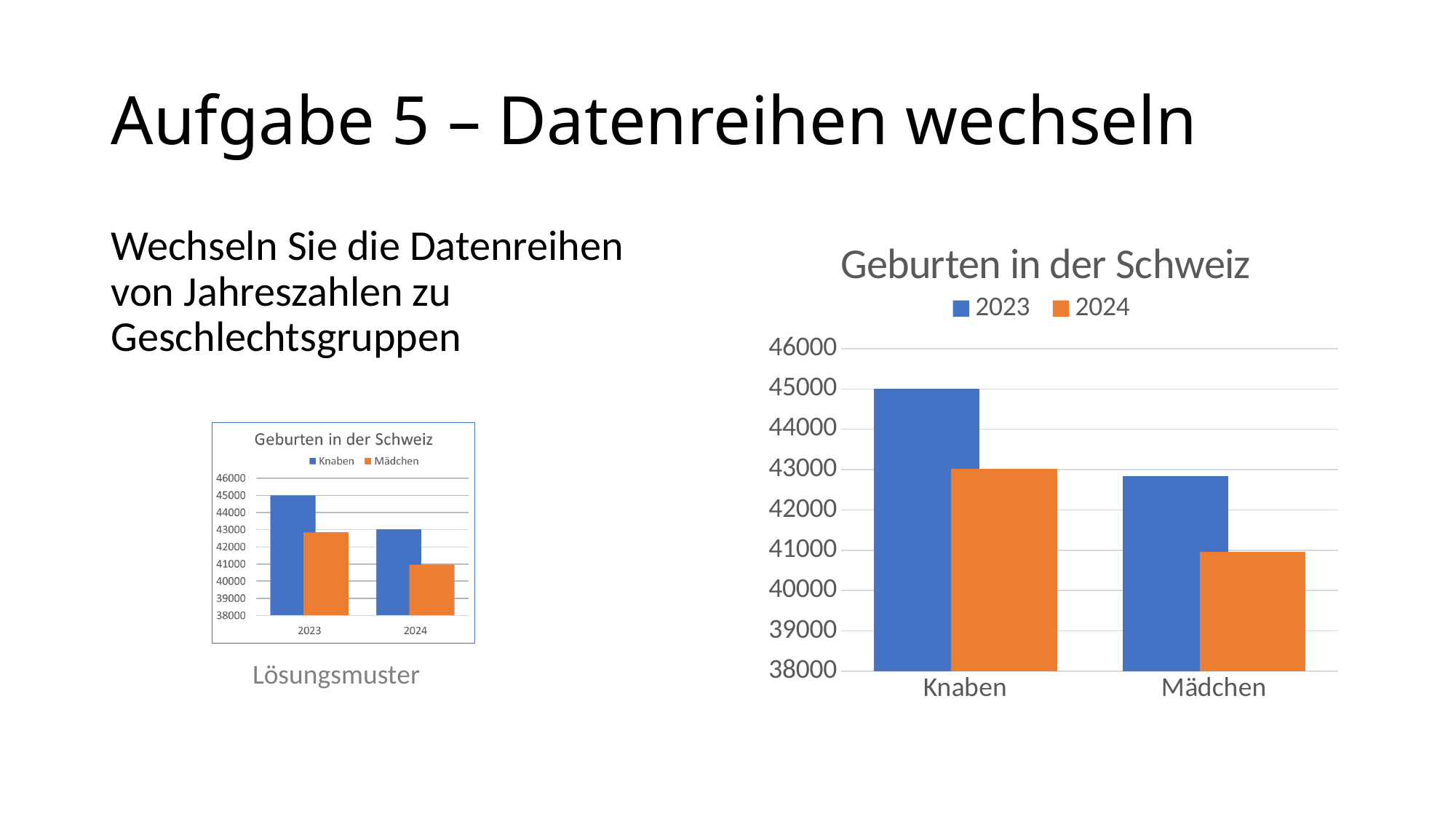
In the large chart on the right, how many categories are shown on the x axis? 2 In the large chart on the right, which category has the larger 2023 value, Knaben or Mädchen? Knaben What kind of chart is the large chart on the right titled "Geburten in der Schweiz"? bar chart In the large chart on the right, is the value for Mädchen in 2023 greater or less than 43000? less In the large chart on the right, is the value for Mädchen in 2024 greater or less than 42000? less In the small chart on the left labelled "Lösungsmuster", which year has the higher Knaben value? 2023 In the large chart on the right, what are the legend entries? 2023, 2024 In the large chart on the right, how many series does the legend list? 2 In the small chart on the left labelled "Lösungsmuster", what are the legend entries? Knaben, Mädchen